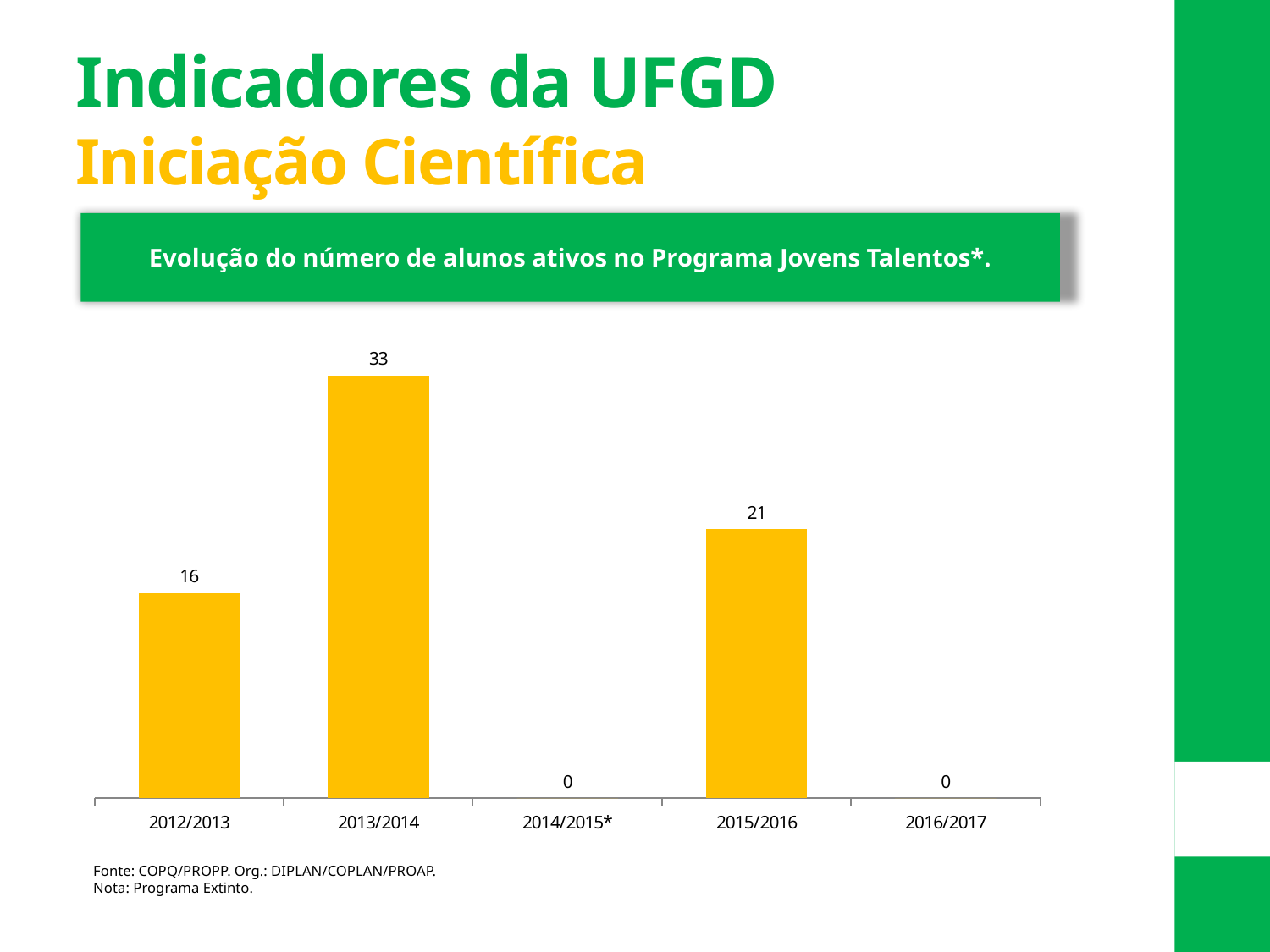
How many periods show a value of 0? 2 What is the title of the chart? Evolução do número de alunos ativos no Programa Jovens Talentos*. What kind of chart is shown on the slide? Bar chart What is the number of active students in the Programa Jovens Talentos for 2012/2013? 16 What is the value shown for 2014/2015*? 0 What is the value shown for 2015/2016? 21 What is the difference between the values for 2013/2014 and 2015/2016? 12 What is the difference between the values for 2013/2014 and 2012/2013? 17 Which period has the highest number of active students? 2013/2014 How many periods are shown on the x axis? 5 What is the value shown for 2013/2014? 33 Which is larger, the value for 2012/2013 or the value for 2015/2016? 2015/2016